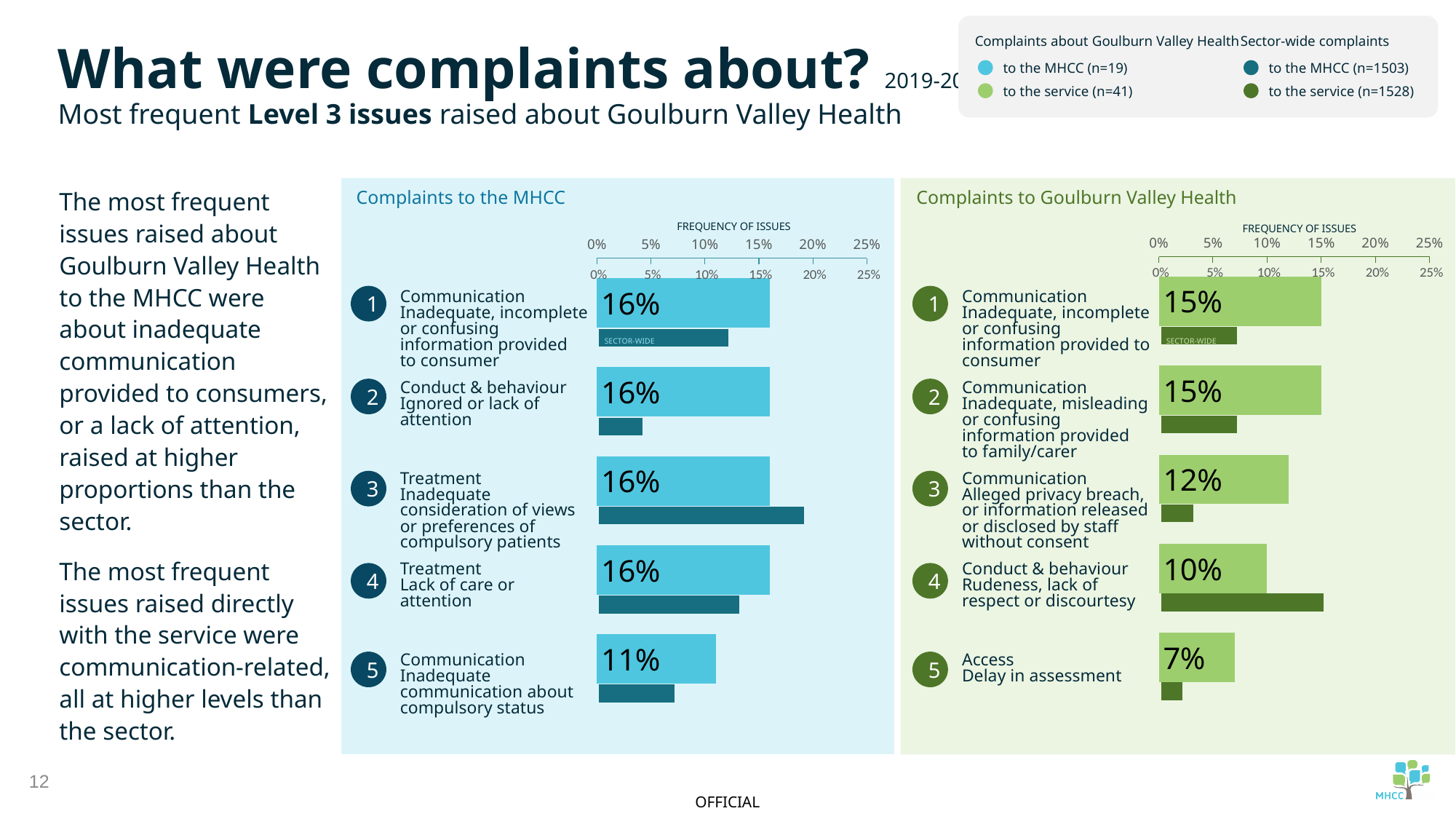
How many issues are listed in the 'Complaints to Goulburn Valley Health' chart? 5 In the 'Complaints to Goulburn Valley Health' chart, which has the higher frequency: 'Communication – Alleged privacy breach' or 'Conduct & behaviour – Rudeness, lack of respect or discourtesy'? Communication – Alleged privacy breach In the 'Complaints to the MHCC' chart, which issue has the lowest frequency? Communication – Inadequate communication about compulsory status In the 'Complaints to Goulburn Valley Health' chart, which issue has the lowest frequency? Access – Delay in assessment In the 'Complaints to Goulburn Valley Health' chart, what is the frequency for 'Access – Delay in assessment'? 7% What kind of chart is the 'Complaints to the MHCC' chart? Bar chart In the 'Complaints to Goulburn Valley Health' chart, what is the difference between the frequency for issue 1 (Communication – Inadequate, incomplete or confusing information provided to consumer) and issue 5 (Access – Delay in assessment)? 8% In the 'Complaints to the MHCC' chart, what is the difference between the frequency for 'Treatment – Lack of care or attention' and 'Communication – Inadequate communication about compulsory status'? 5% In the 'Complaints to the MHCC' chart, what is the frequency for 'Communication – Inadequate communication about compulsory status'? 11% In the 'Complaints to the MHCC' chart, is the sector-wide value for 'Treatment – Inadequate consideration of views or preferences of compulsory patients' greater or less than 15%? greater According to the legend, how many sector-wide complaints were made to the service? n=1528 In the 'Complaints to Goulburn Valley Health' chart, what is the frequency for 'Conduct & behaviour – Rudeness, lack of respect or discourtesy'? 10%